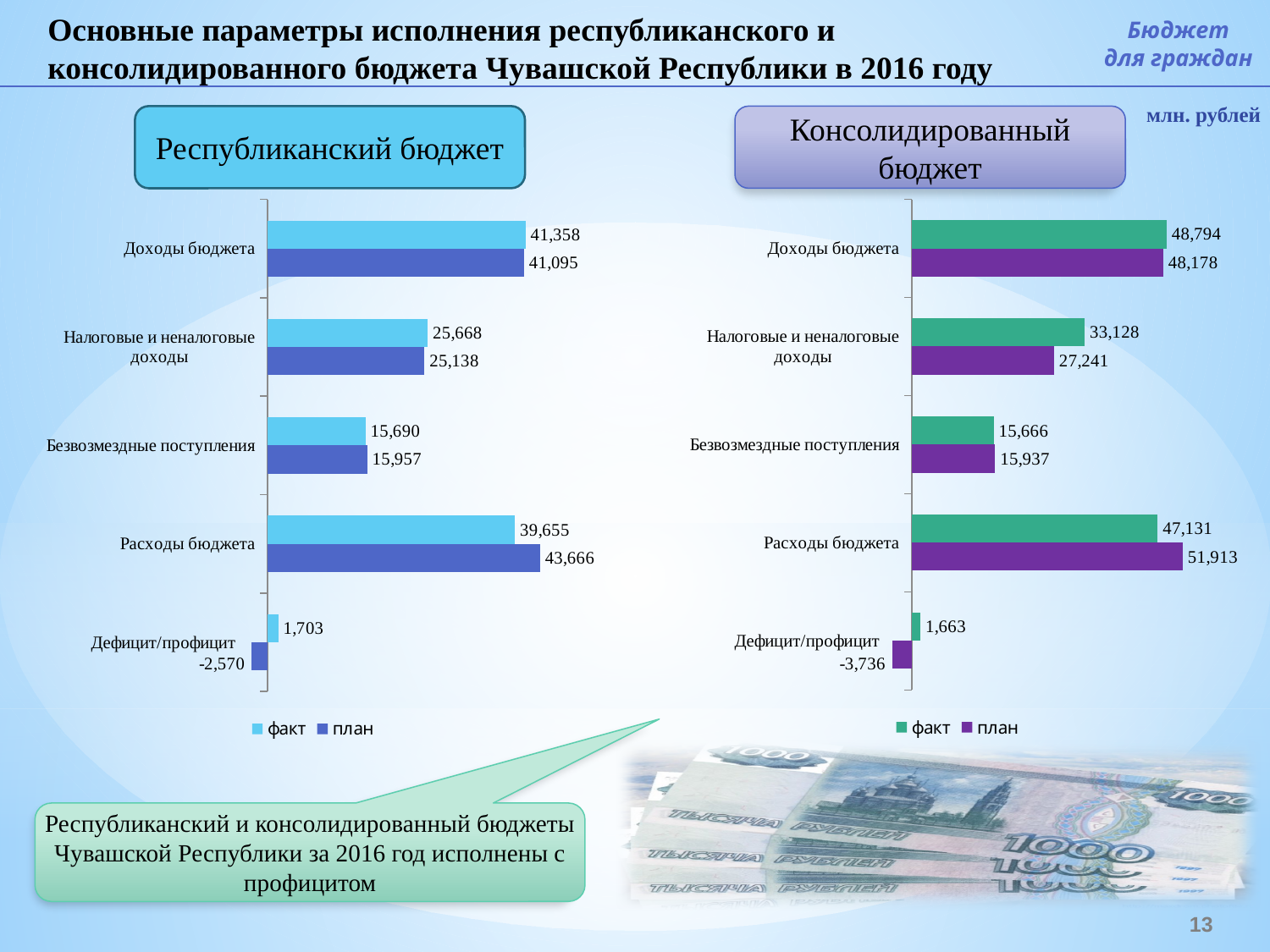
In the 'Республиканский бюджет' chart, what is the план value for Расходы бюджета? 43,666 In the 'Консолидированный бюджет' chart, which category has the highest план value? Расходы бюджета In the 'Консолидированный бюджет' chart, what is the difference between the факт and план values for Налоговые и неналоговые доходы? 5,887 In the 'Республиканский бюджет' chart, what is the факт value for Доходы бюджета? 41,358 In the 'Республиканский бюджет' chart, which category has the lowest факт value? Дефицит/профицит In the 'Консолидированный бюджет' chart, what is the факт value for Налоговые и неналоговые доходы? 33,128 In the 'Республиканский бюджет' chart, which is larger for Безвозмездные поступления: факт or план? план In the 'Республиканский бюджет' chart, what is the difference between the план and факт values for Расходы бюджета? 4,011 How many categories are shown in the 'Консолидированный бюджет' chart? 5 In the 'Консолидированный бюджет' chart, what is the план value for Дефицит/профицит? -3,736 What type of chart is the 'Консолидированный бюджет' chart? Bar chart How many series does the legend of the 'Республиканский бюджет' chart list? 2